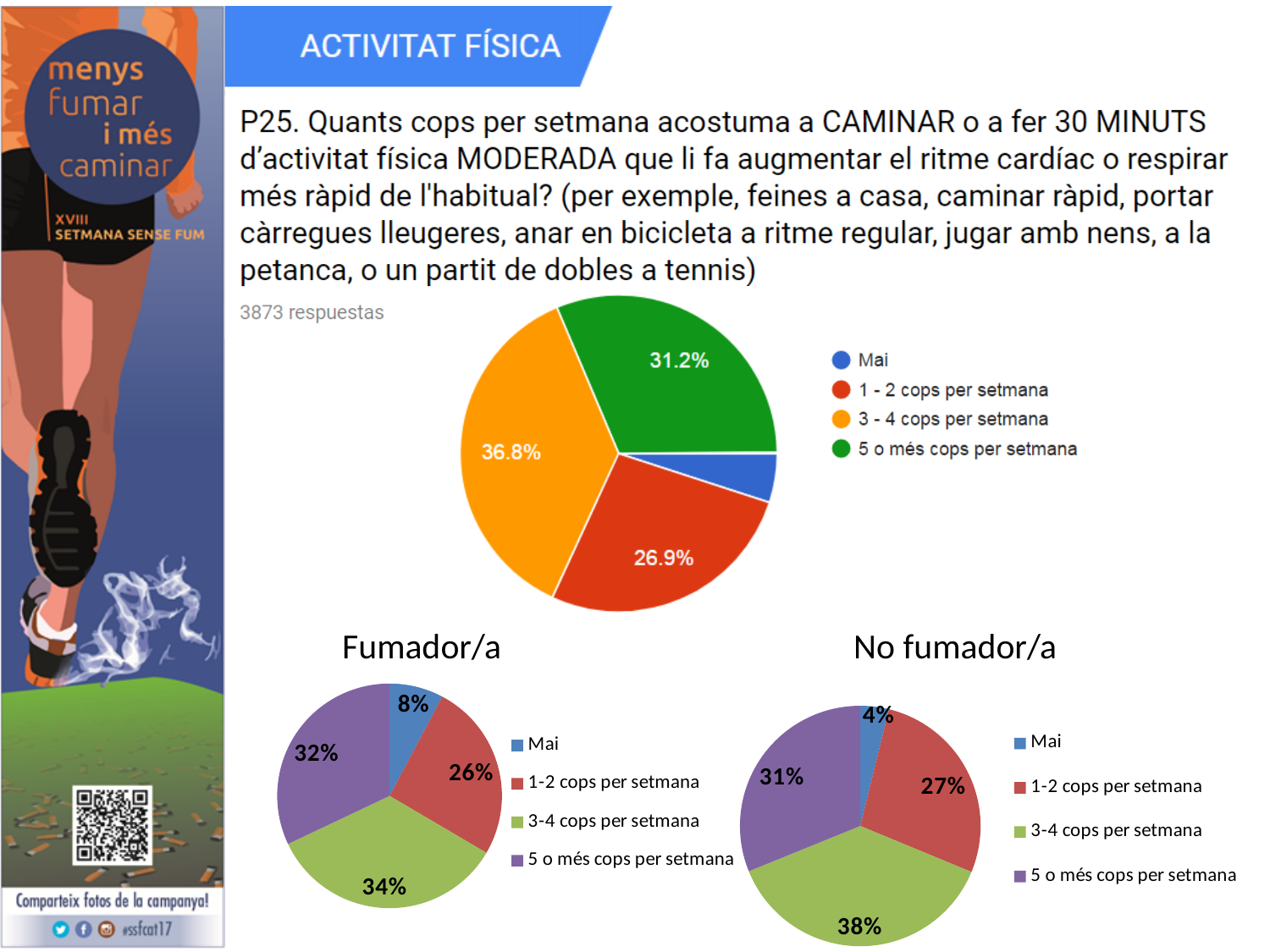
In the top pie chart, what share of responses is '3 - 4 cops per setmana'? 36.8% In the top pie chart, what share of responses is '1 - 2 cops per setmana'? 26.9% In the 'Fumador/a' pie chart, what is the share for 'Mai'? 8% What type of chart is used for the 'Fumador/a' and 'No fumador/a' data? Pie chart Which is larger: the 'Mai' share in the 'Fumador/a' chart or in the 'No fumador/a' chart? Fumador/a In the top pie chart, which category has the smallest slice? Mai How many categories does the legend of the top pie chart list? 4 In the 'Fumador/a' pie chart, which category has the largest share? 3-4 cops per setmana In the top pie chart, what is the difference between the '3 - 4 cops per setmana' and '5 o més cops per setmana' shares? 5.6% In the 'No fumador/a' pie chart, what is the share for '3-4 cops per setmana'? 38% In the top pie chart, which category has the largest slice? 3 - 4 cops per setmana In the 'No fumador/a' pie chart, what is the share for 'Mai'? 4%